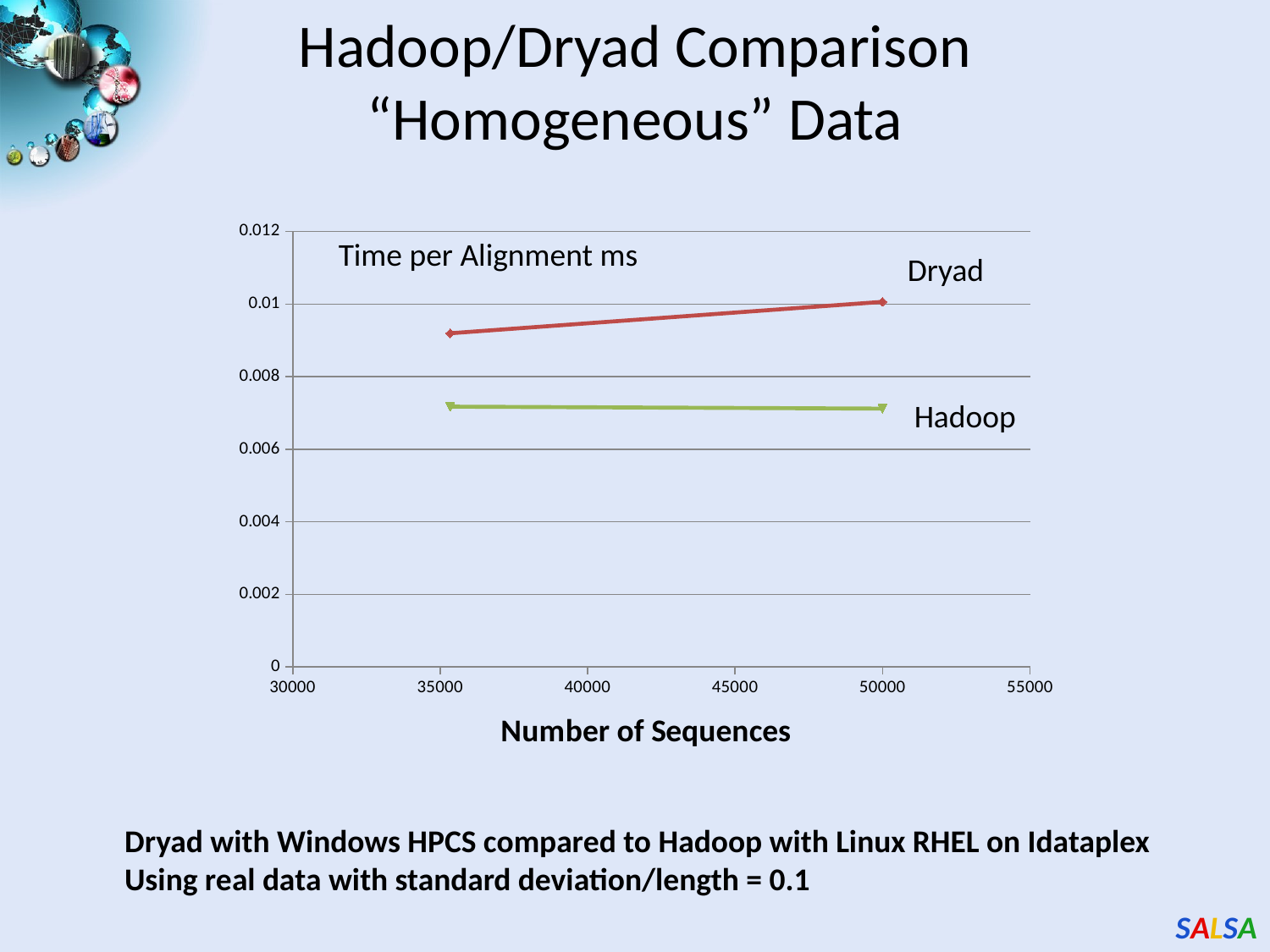
Is the Dryad value at 50000 sequences greater or less than 0.008? greater How many series are plotted on the chart? 2 What kind of chart is shown on the slide? line chart Is the Hadoop value at 50000 sequences greater or less than 0.006? greater Which series has the higher time per alignment at 50000 sequences, Dryad or Hadoop? Dryad Does the Dryad line rise or fall as the number of sequences increases from 35000 to 50000? rises How many data points are plotted for the Dryad series? 2 What quantity does the chart's label say is plotted on the y axis? Time per Alignment ms Which series has the lower time per alignment at 35000 sequences? Hadoop Is the Dryad value at 35000 sequences greater or less than 0.008? greater What is the title of the x axis? Number of Sequences